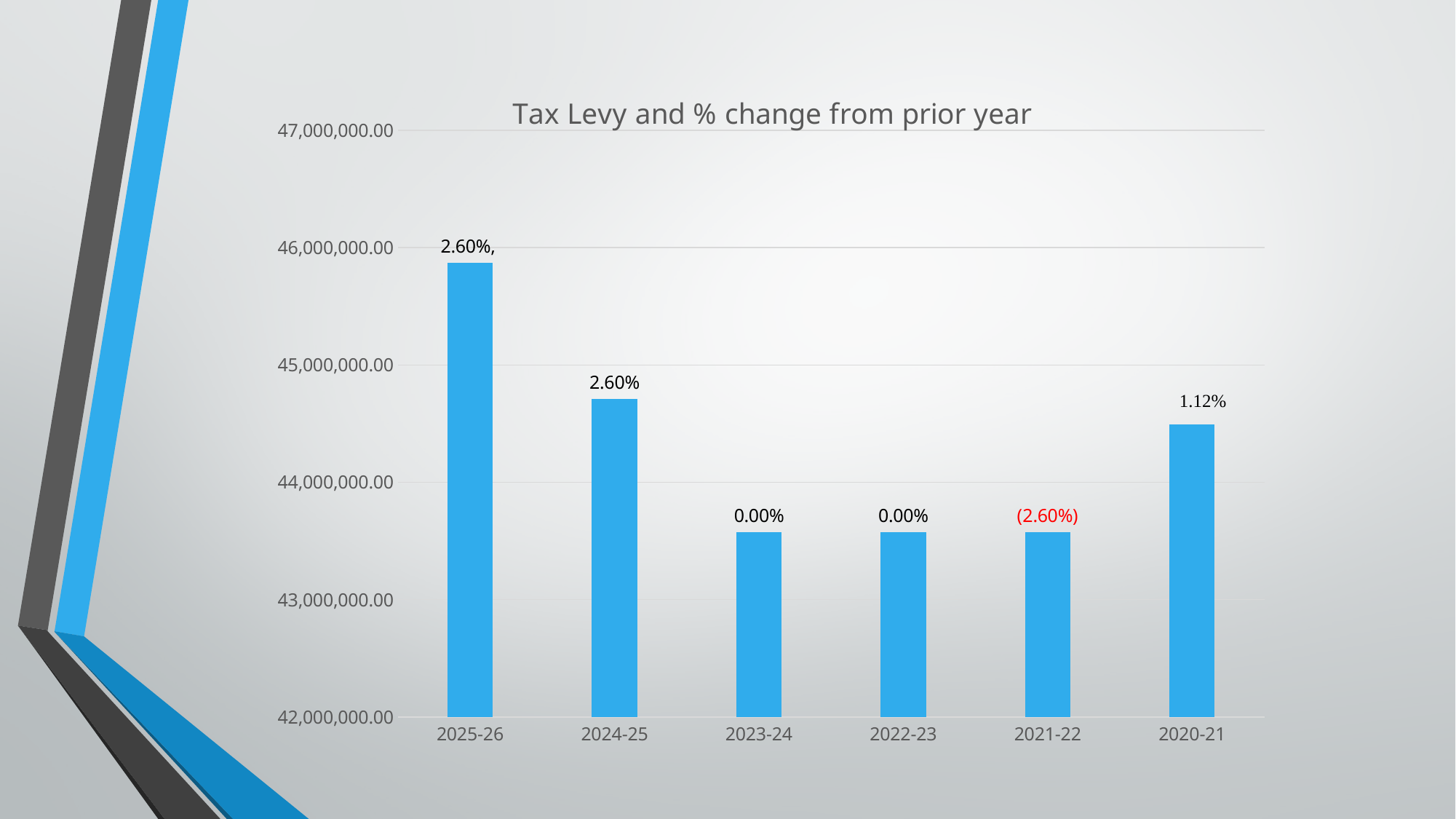
Which fiscal year's data label is shown in red? 2021-22 Is the tax levy for 2025-26 greater or less than 45,000,000.00? greater Is the tax levy for 2023-24 greater or less than 44,000,000.00? less How many fiscal years are shown on the x axis of the chart? 6 What % change from prior year is labelled on the 2023-24 bar? 0.00% What is the title of the chart? Tax Levy and % change from prior year What % change from prior year is labelled on the 2024-25 bar? 2.60% What % change from prior year is labelled on the 2021-22 bar? (2.60%) Which has the larger tax levy, 2025-26 or 2024-25? 2025-26 Which fiscal year has the tallest bar (highest tax levy)? 2025-26 What % change from prior year is labelled on the 2020-21 bar? 1.12% What type of chart is shown on the slide? bar chart